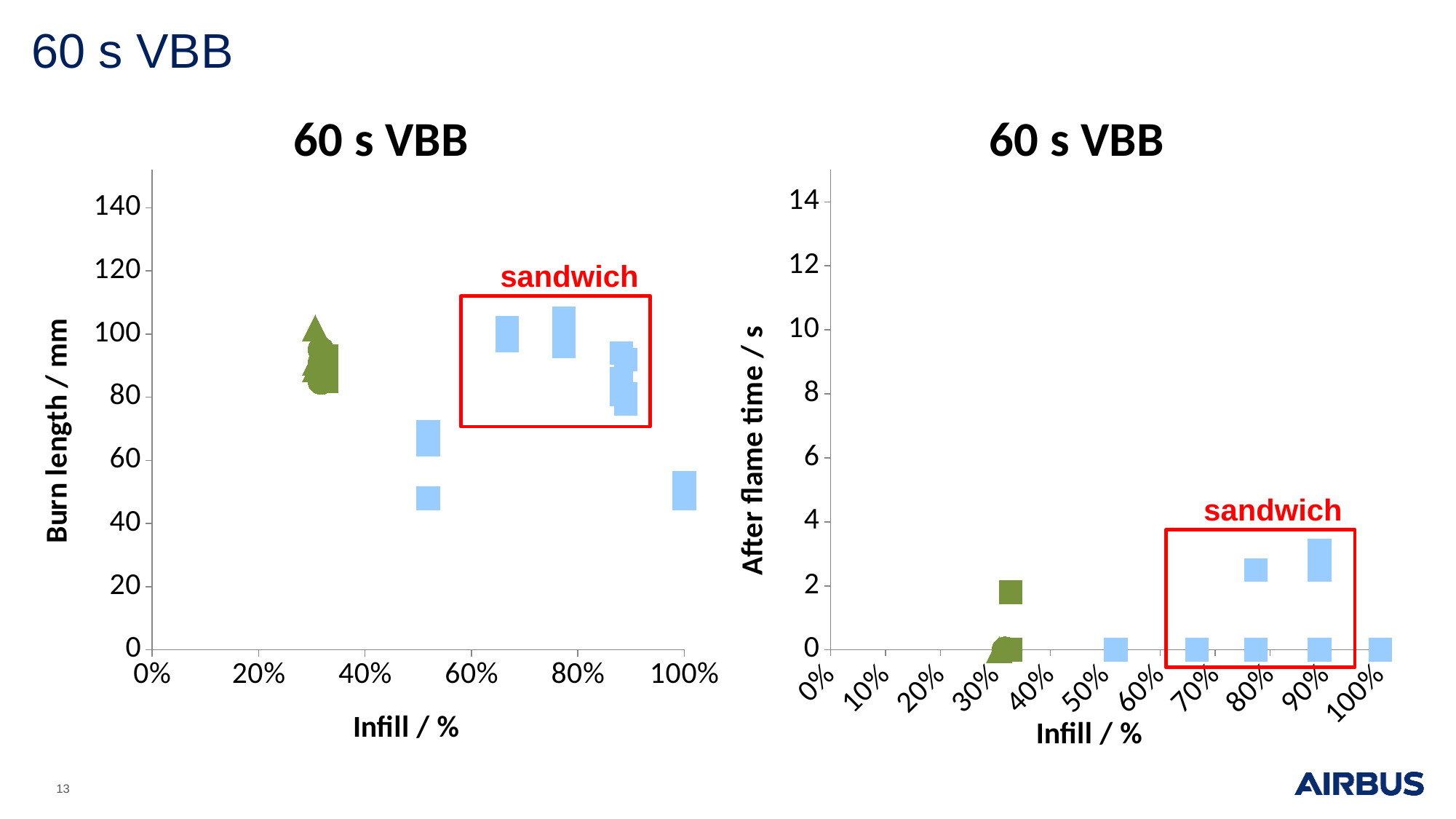
In the left chart, are the burn length values for the points near 67% infill greater or less than 80? greater What is the y-axis title of the left chart? Burn length / mm What kind of chart is the left chart on the slide? scatter chart In the right chart, is the after flame time for the point at 100% infill greater or less than 2? less How many charts are shown on the slide? 2 In the left chart, is the burn length for the point at 100% infill greater or less than 80? less In the left chart, which infill value has the lowest plotted burn length: 67% or 100%? 100% What kind of chart is the right chart on the slide? scatter chart What is the y-axis title of the right chart? After flame time / s